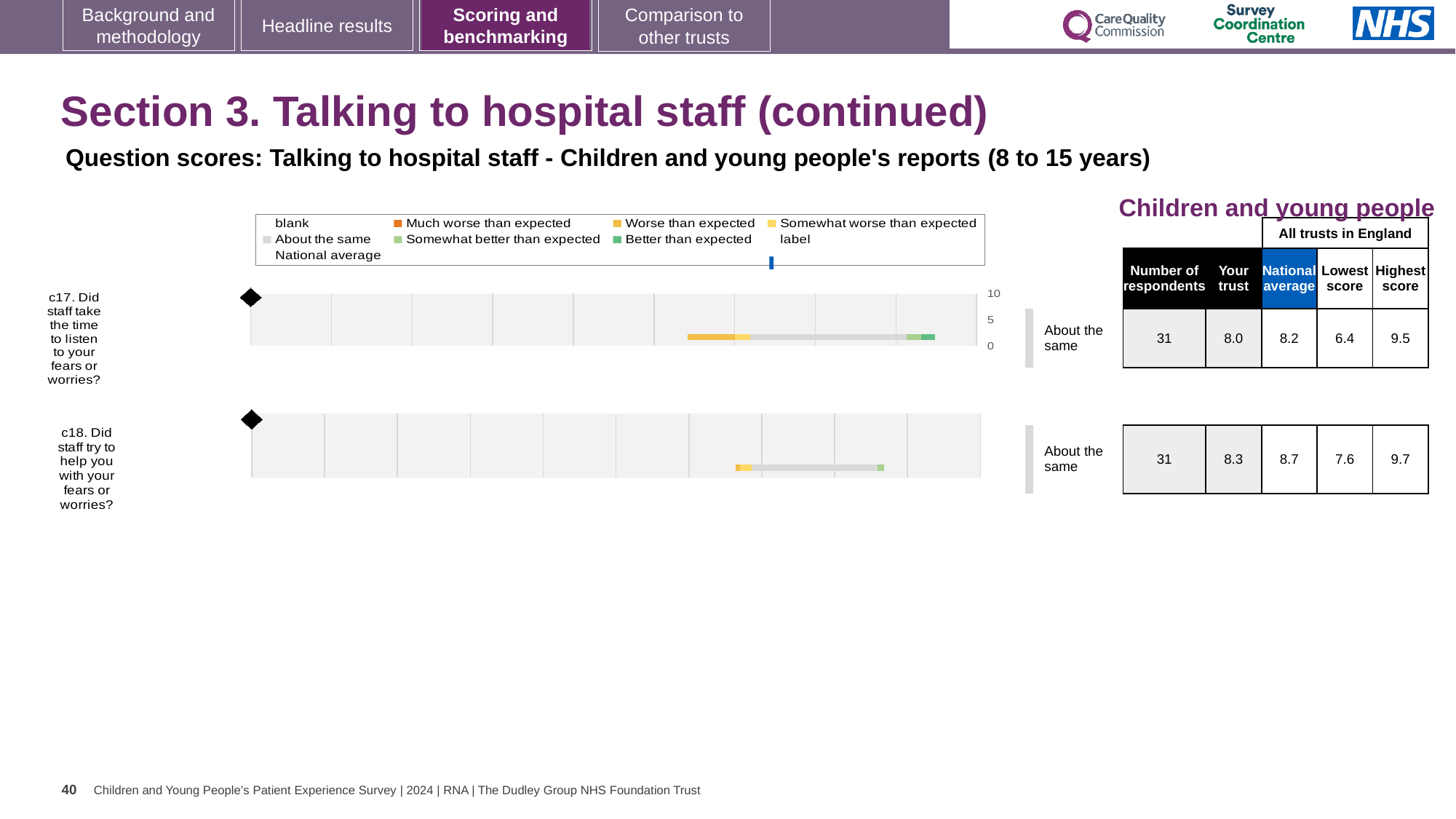
What kind of chart is used to show the benchmarking results for questions c17 and c18? bar chart What is the difference between the 'Your trust' scores for c18 and c17? 0.3 What benchmarking category is shown for question c17? About the same What is the highest score among all trusts in England for question c18? 9.7 For question c18, which is larger: the trust's score or the national average? National average How many respondents answered question c18? 31 What is the national average score for question c17? 8.2 How many entries does the legend above the charts list? 9 What is the lowest score among all trusts in England for question c17? 6.4 How many questions (categories) are plotted in the benchmarking charts on this slide? 2 What is the 'Your trust' score for question c17 (Did staff take the time to listen to your fears or worries?)? 8.0 What is the 'Your trust' score for question c18 (Did staff try to help you with your fears or worries?)? 8.3